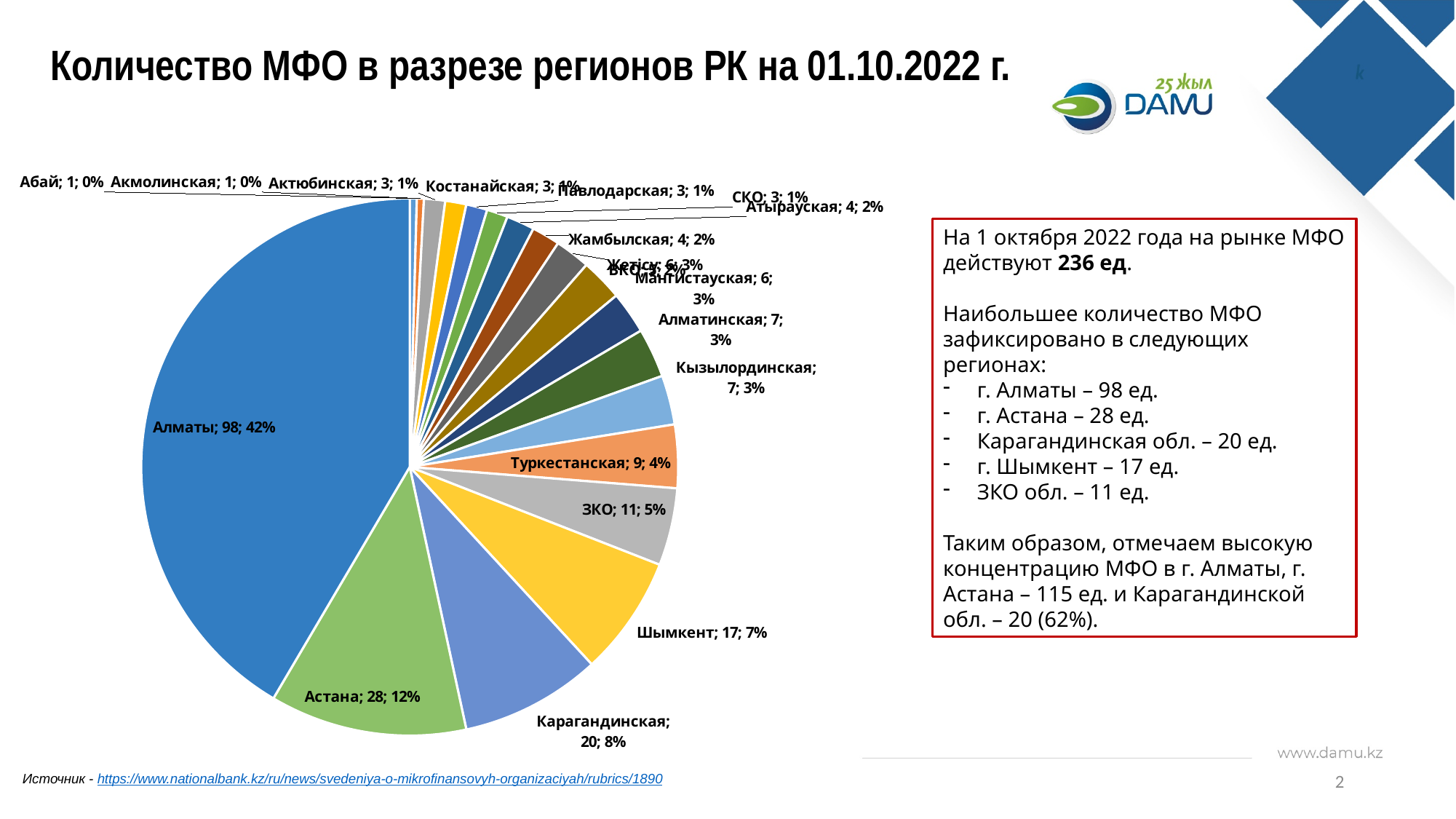
How many МФО are shown for Туркестанская in the pie chart? 9 How many МФО are shown for Астана in the pie chart? 28 What is the difference between the number of МФО in Алматы and in Астана? 70 How many МФО are shown for Карагандинская in the pie chart? 20 What share of the pie does Алматы account for? 42% What is the title of the chart on the slide? Количество МФО в разрезе регионов РК на 01.10.2022 г. What share of the pie does Астана account for? 12% How many МФО are shown for Шымкент in the pie chart? 17 How many МФО are shown for ЗКО in the pie chart? 11 Which has more МФО, Карагандинская or Шымкент? Карагандинская What kind of chart is shown on the slide? pie chart Which region has the largest number of МФО in the pie chart? Алматы